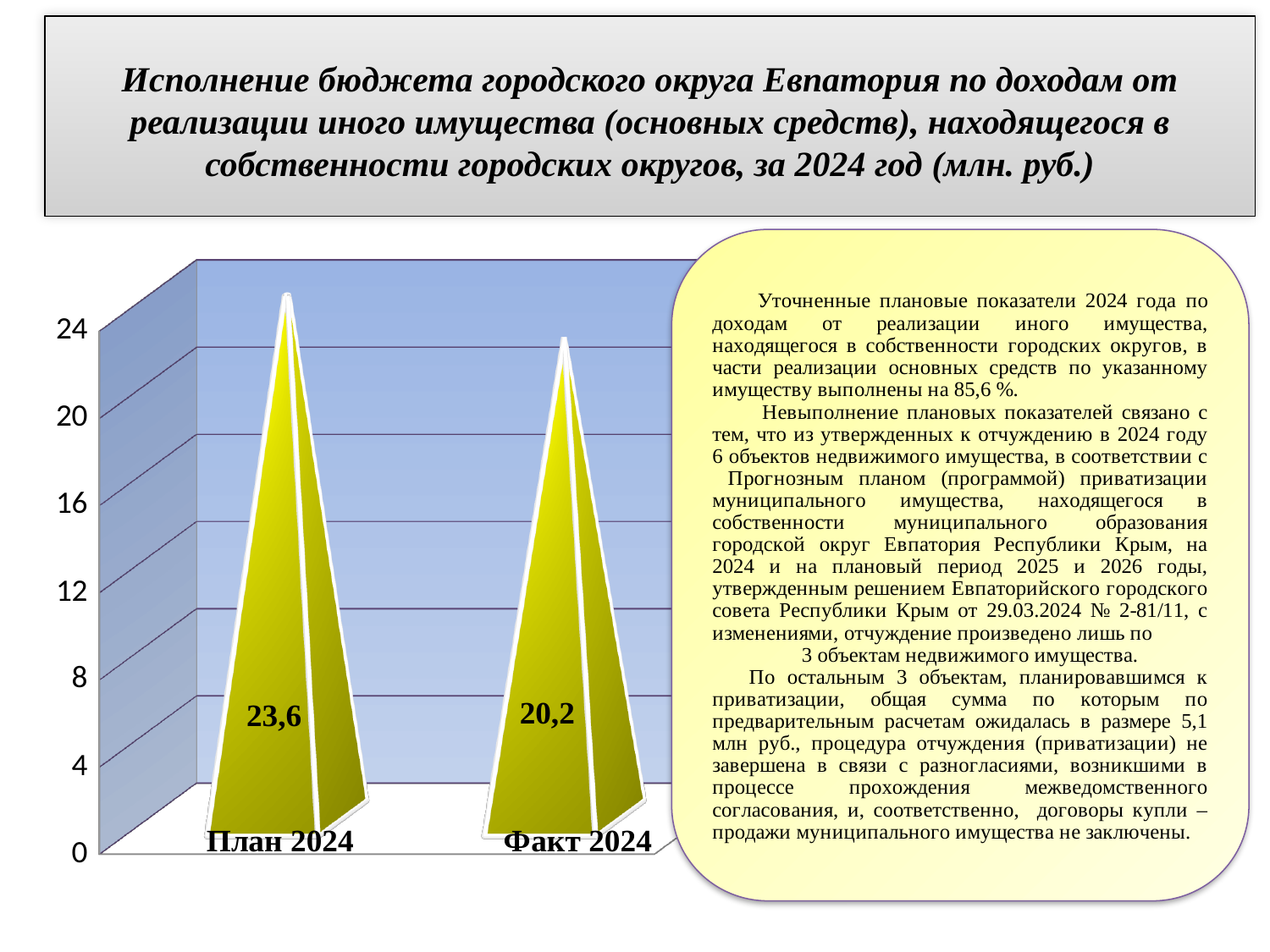
What is the value for План 2024? 23,6 How many categories are shown on the chart? 2 What kind of chart is shown on the slide? bar chart Do the values rise or fall from План 2024 to Факт 2024? fall Which category has the lowest value? Факт 2024 Is the value for Факт 2024 greater or less than 24? less Is the value for План 2024 greater or less than 20? greater Which category has the highest value? План 2024 What is the highest tick value shown on the vertical axis of the chart? 24 What is the value for Факт 2024? 20,2 What is the difference between the values for План 2024 and Факт 2024? 3,4 Which is larger, the value for План 2024 or the value for Факт 2024? План 2024